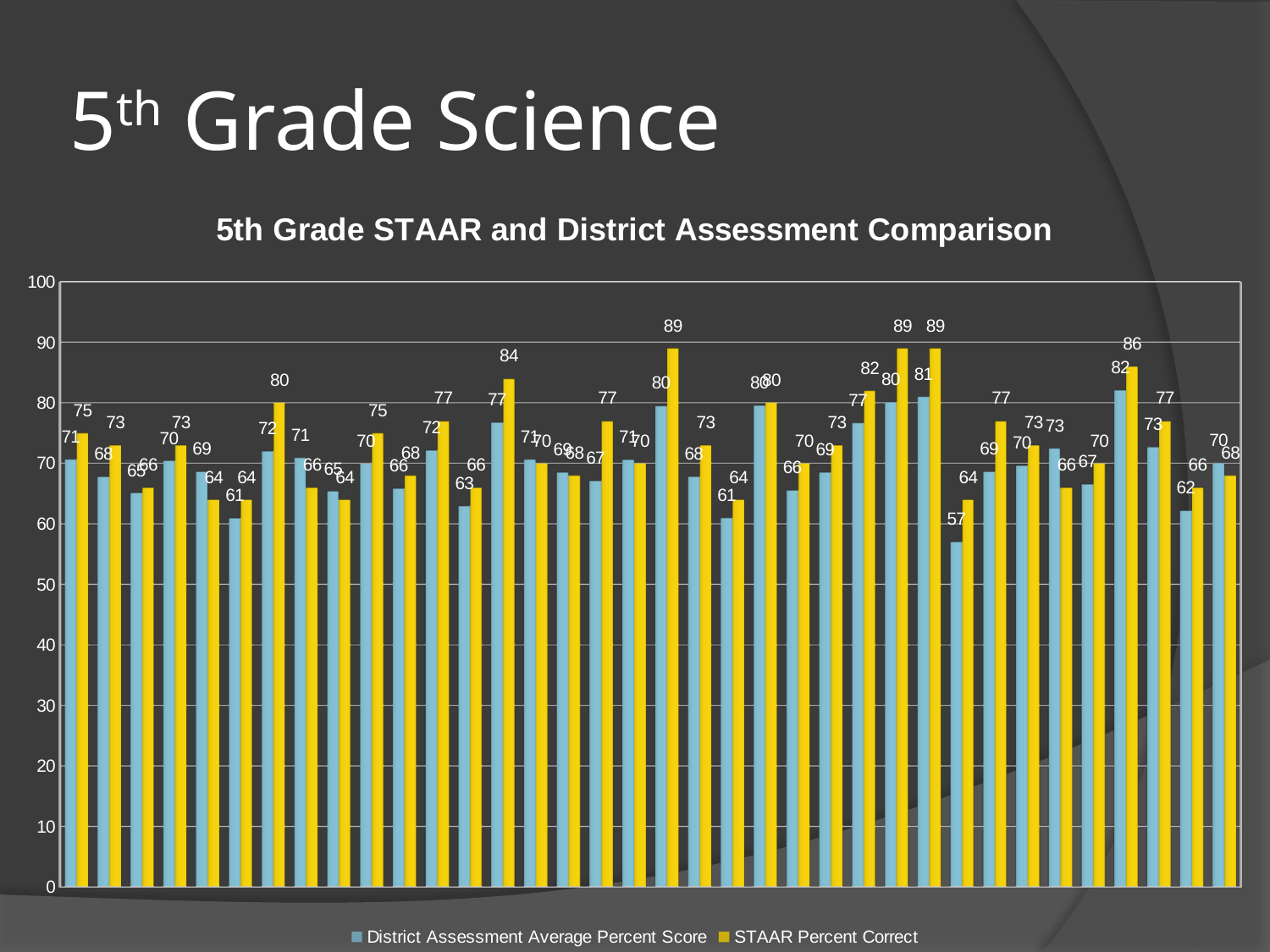
What is the difference between the highest STAAR Percent Correct value and the lowest District Assessment Average Percent Score? 32 What is the lowest District Assessment Average Percent Score shown in the chart? 57 Which is larger: the highest District Assessment Average Percent Score or the highest STAAR Percent Correct value? the highest STAAR Percent Correct value What kind of chart is shown on the slide? bar chart Which series is shown in yellow in the chart? STAAR Percent Correct What is the maximum value shown on the vertical axis of the chart? 100 What is the lowest STAAR Percent Correct value shown in the chart? 64 What is the title of the chart? 5th Grade STAAR and District Assessment Comparison What is the highest STAAR Percent Correct value shown in the chart? 89 Is the highest STAAR Percent Correct value greater or less than 90? less How many series does the chart's legend list? 2 What is the highest District Assessment Average Percent Score shown in the chart? 82